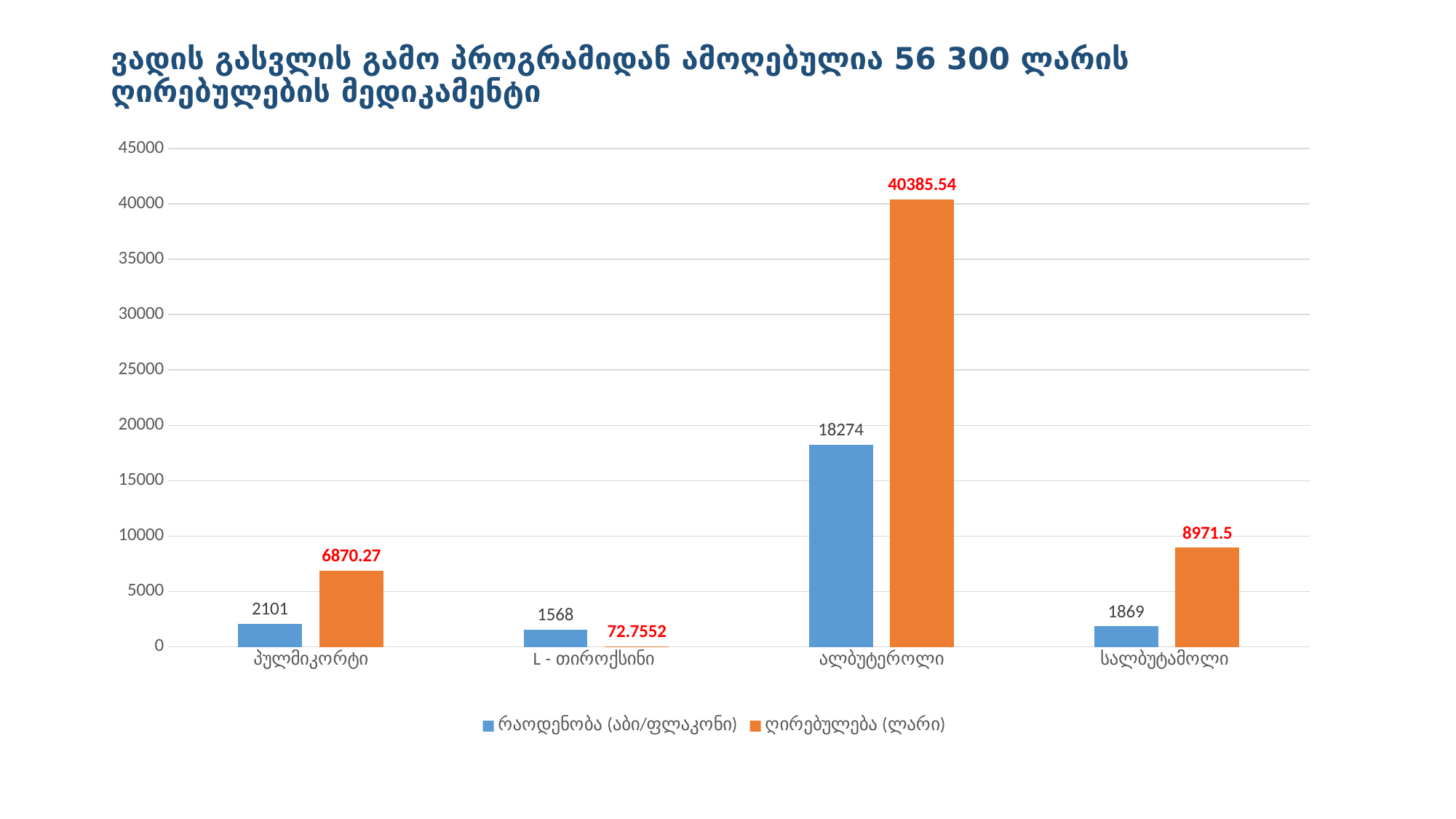
What is the value of რაოდენობა (აბი/ფლაკონი) for სალბუტამოლი? 1869 How many categories are shown on the x axis? 4 What kind of chart is shown on the slide? bar chart What is the difference between the ღირებულება (ლარი) values for სალბუტამოლი and პულმიკორტი? 2101.23 Which category has the lowest რაოდენობა (აბი/ფლაკონი)? L - თიროქსინი What is the value of ღირებულება (ლარი) for L - თიროქსინი? 72.7552 How many series does the legend list? 2 Which is larger: the რაოდენობა (აბი/ფლაკონი) for პულმიკორტი or for სალბუტამოლი? პულმიკორტი Which category has the highest ღირებულება (ლარი)? ალბუტეროლი What is the value of ღირებულება (ლარი) for პულმიკორტი? 6870.27 What is the value of რაოდენობა (აბი/ფლაკონი) for ალბუტეროლი? 18274 Is the ღირებულება (ლარი) value for ალბუტეროლი greater or less than 35000? greater